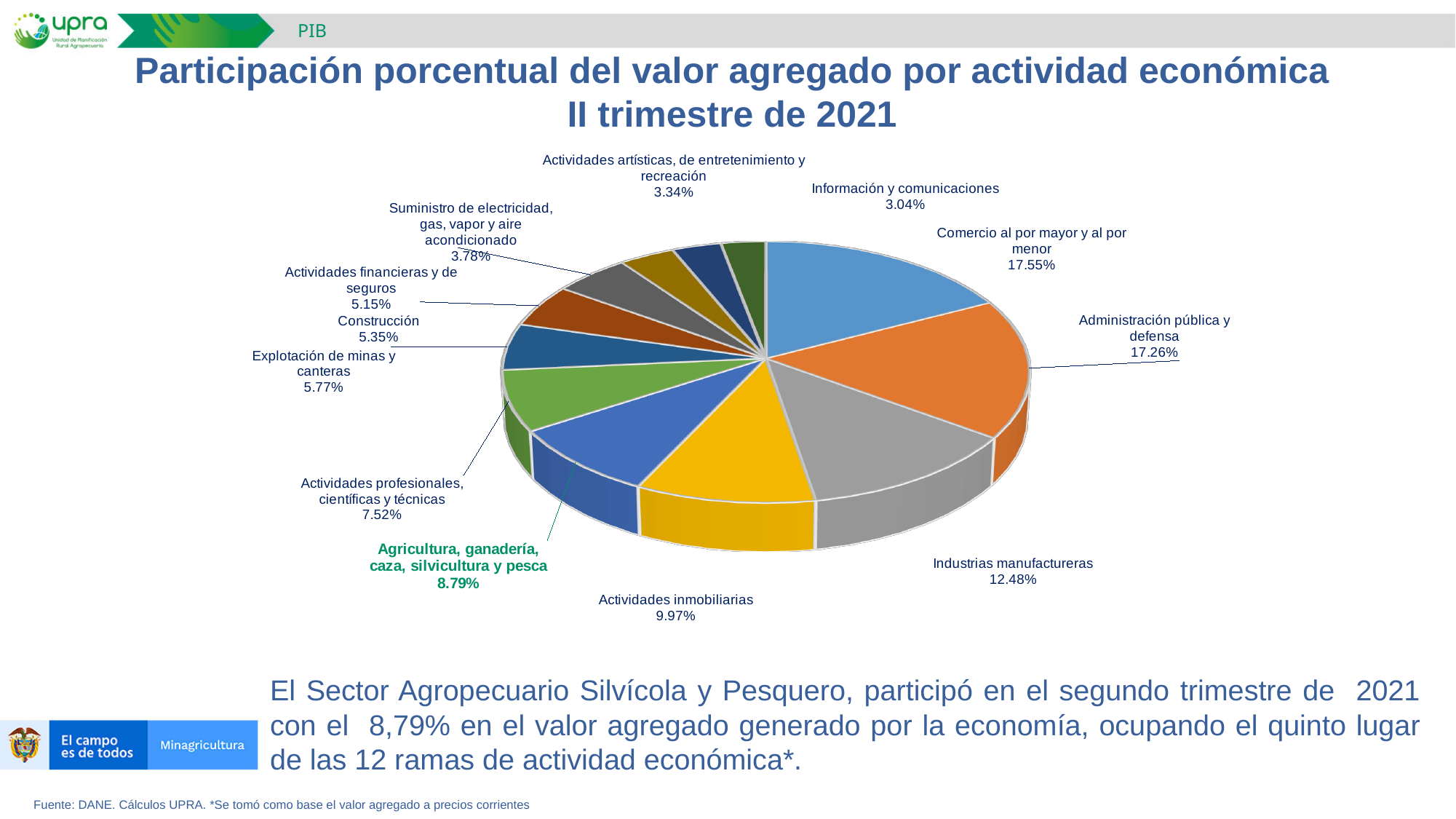
Which has a larger share, Explotación de minas y canteras or Suministro de electricidad, gas, vapor y aire acondicionado? Explotación de minas y canteras What type of chart is shown on the slide? Pie chart How many economic activities (slices) are shown in the pie chart? 12 Which has a larger share, Construcción or Actividades financieras y de seguros? Construcción What value is labelled for Actividades inmobiliarias? 9.97% What is the difference in percentage points between Comercio al por mayor y al por menor and Administración pública y defensa? 0.29 What is the difference in percentage points between Industrias manufactureras and Actividades inmobiliarias? 2.51 What is the share shown for Industrias manufactureras? 12.48% What percentage share does Agricultura, ganadería, caza, silvicultura y pesca have in the pie chart? 8.79% What is the title of the chart on the slide? Participación porcentual del valor agregado por actividad económica II trimestre de 2021 Which economic activity has the smallest share in the pie chart? Información y comunicaciones Which economic activity has the largest share in the pie chart? Comercio al por mayor y al por menor